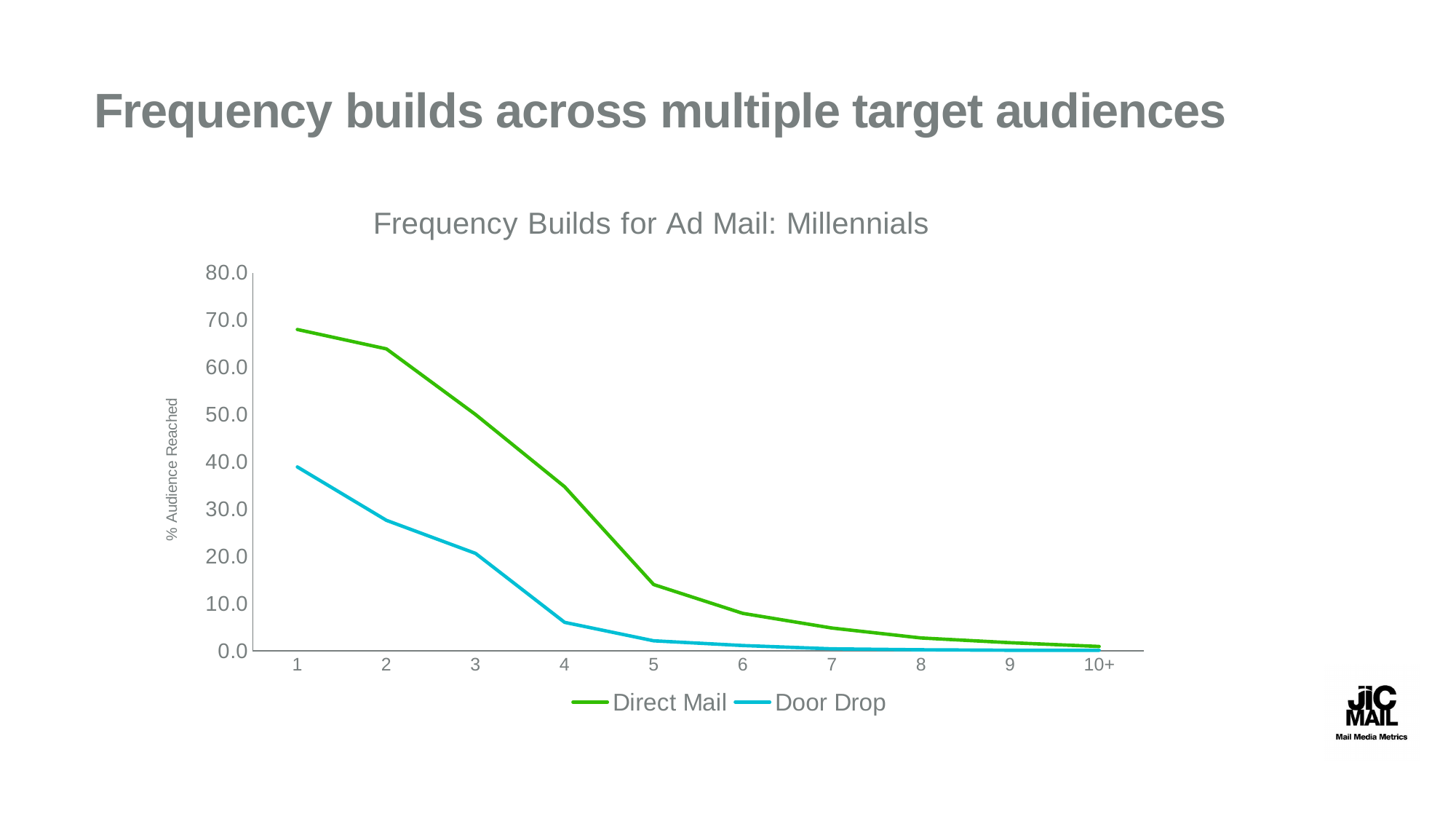
How many series does the legend list? 2 Do the Direct Mail values rise or fall as you move along the x axis from 1 to 10+? Fall Is the Direct Mail value at category 1 greater or less than 60? greater What kind of chart is shown on the slide? Line chart At category 3, which series has the larger value, Direct Mail or Door Drop? Direct Mail Is the Door Drop value at category 4 greater or less than 10? less What is the title of the chart? Frequency Builds for Ad Mail: Millennials At which x-axis category is the Direct Mail value highest? 1 Is the Direct Mail value at category 5 greater or less than 10? greater How many categories are shown on the x axis? 10 Do the Door Drop values rise or fall as you move along the x axis from 1 to 10+? Fall